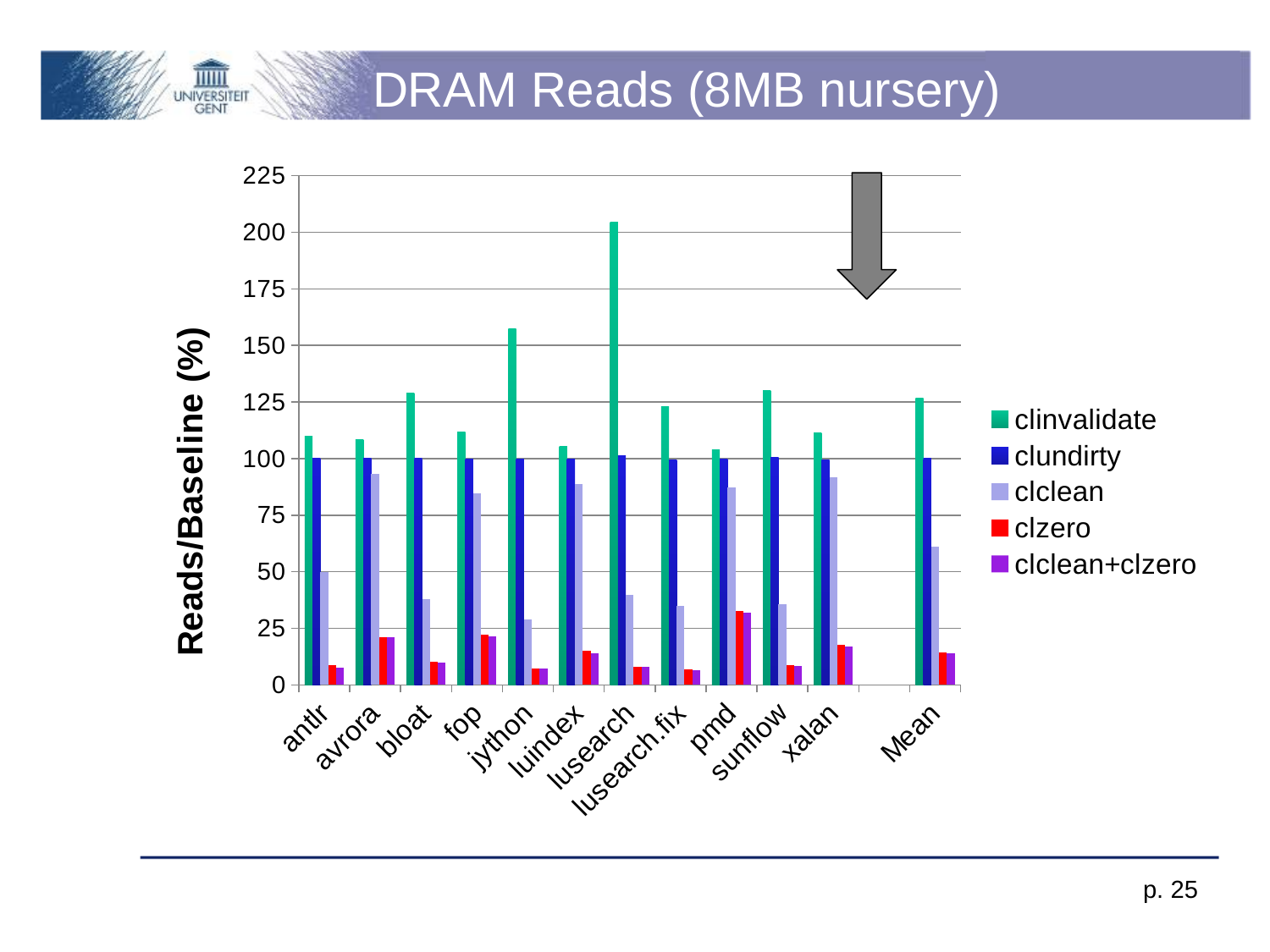
What is the title of the chart? DRAM Reads (8MB nursery) Is the clclean value for Mean greater or less than 50? greater For which category is the clzero value highest? pmd How many series does the legend list? 5 For which category is the clinvalidate value highest? lusearch What is the label of the y axis? Reads/Baseline (%) Which is larger, the clinvalidate value for lusearch or for jython? lusearch Is the clinvalidate value for lusearch greater or less than 175? greater For which category is the clclean value lowest? jython What kind of chart is shown on the slide? bar chart How many categories are shown on the x axis? 12 Is the clclean value for bloat greater or less than 50? less